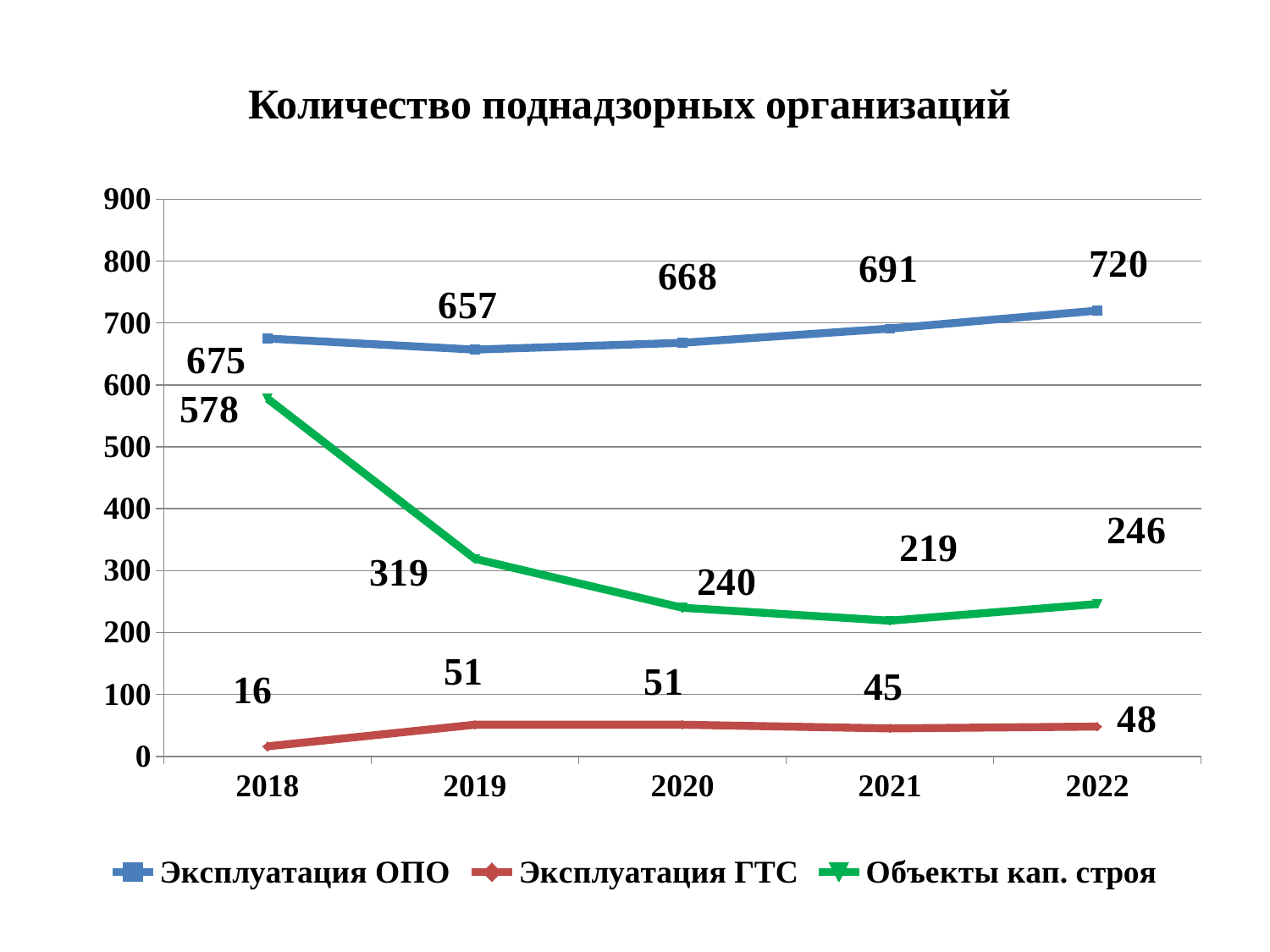
What is the value for Эксплуатация ГТС in 2021? 45 What kind of chart is shown on the slide? line chart What is the difference between the Объекты кап. строя values in 2018 and 2019? 259 How many years are shown on the x axis? 5 What is the value for Объекты кап. строя in 2018? 578 In which year is the value for Объекты кап. строя lowest? 2021 What is the difference between the Эксплуатация ОПО values in 2022 and 2018? 45 What is the value for Эксплуатация ОПО in 2022? 720 Does the value for Объекты кап. строя rise or fall from 2018 to 2021? fall How many series does the legend list? 3 In which year is the value for Эксплуатация ОПО highest? 2022 Which is larger in 2020: the value for Объекты кап. строя or the value for Эксплуатация ГТС? Объекты кап. строя